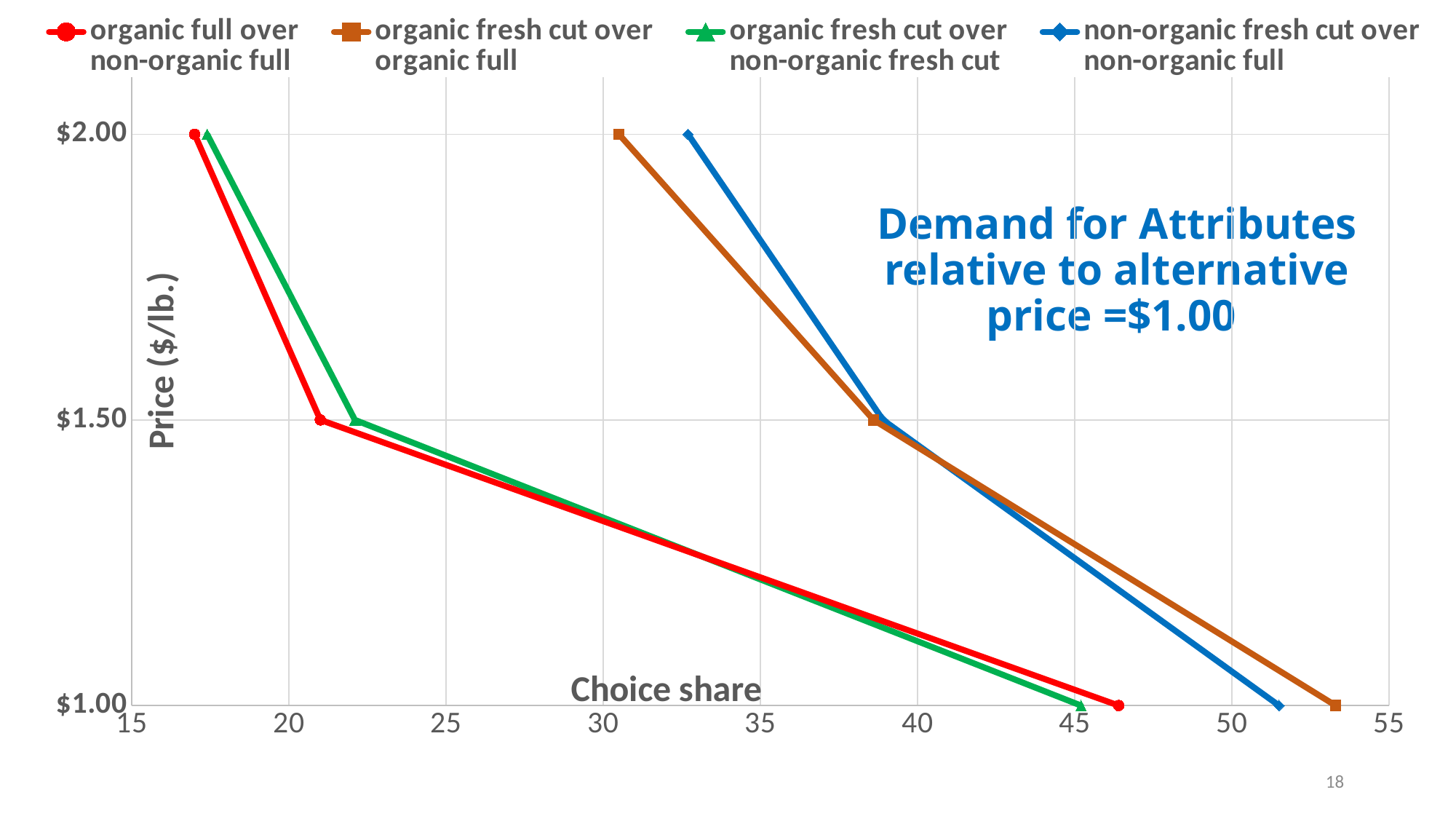
At a price of $2.00, which series has the larger choice share: 'non-organic fresh cut over non-organic full' or 'organic fresh cut over organic full'? non-organic fresh cut over non-organic full What kind of chart is shown on the slide? line chart How many series does the legend list? 4 Which series has the highest choice share at a price of $1.00? organic fresh cut over organic full Is the choice share for 'organic fresh cut over non-organic fresh cut' at a price of $1.00 greater or less than 40? greater What is the label on the horizontal axis of the chart? Choice share Is the choice share for 'organic full over non-organic full' at a price of $2.00 greater or less than 20? less How many price points are plotted for each series? 3 What is the label on the vertical axis of the chart? Price ($/lb.) Is the choice share for 'organic fresh cut over organic full' at a price of $1.00 greater or less than 50? greater As price increases from $1.00 to $2.00, does the choice share for each series rise or fall? fall